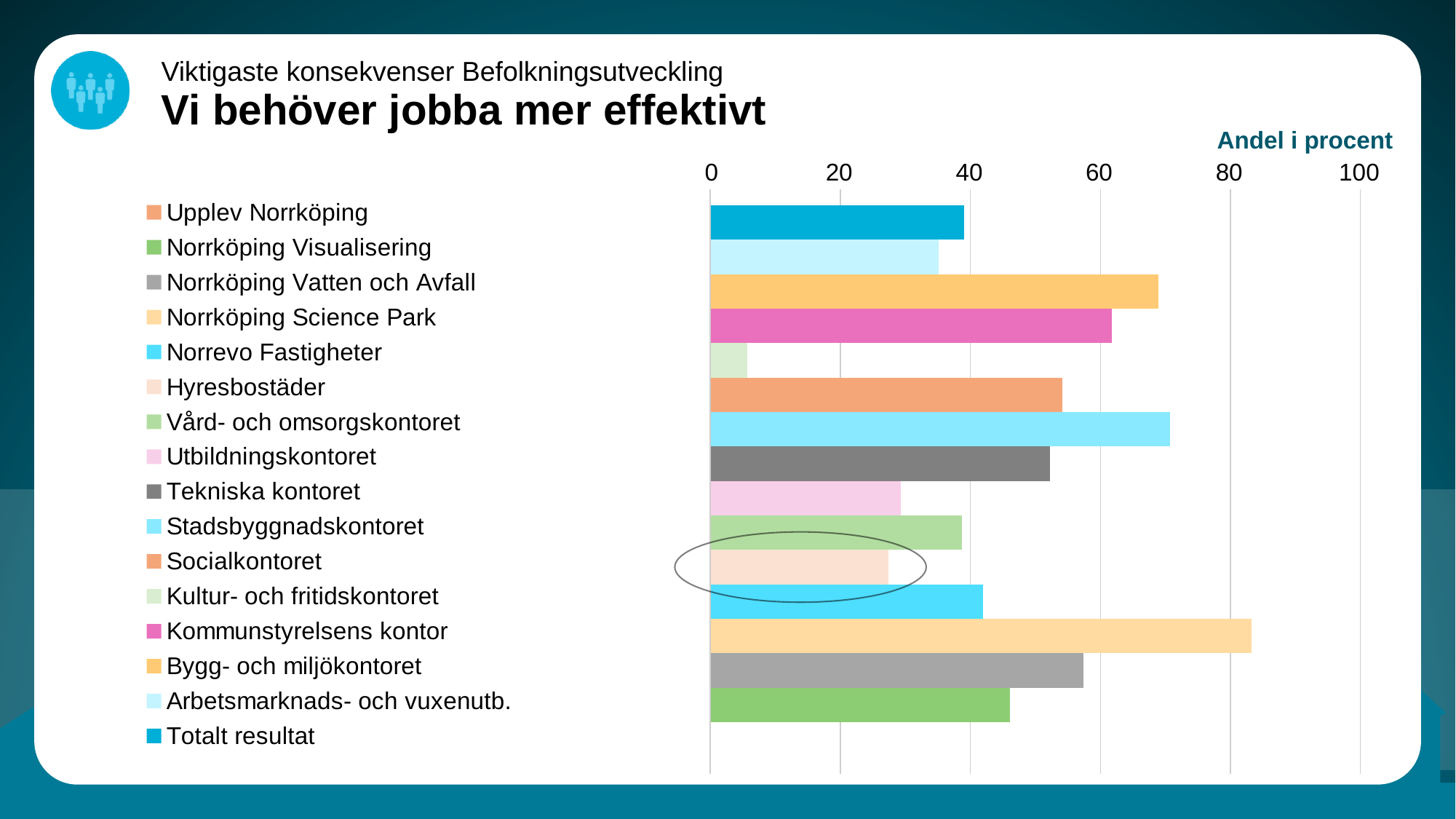
What kind of chart is shown on the slide? bar chart Is the value for Norrköping Science Park greater or less than 80? greater Is the value for Bygg- och miljökontoret greater or less than 60? greater Which is larger, the value for Norrköping Vatten och Avfall or the value for Norrköping Visualisering? Norrköping Vatten och Avfall Is the value for Kultur- och fritidskontoret greater or less than 20? less Which category has the highest value in the chart? Norrköping Science Park How many entries does the chart legend list? 16 What is the label shown above the chart's value axis? Andel i procent Which is larger, the value for Kommunstyrelsens kontor or the value for Socialkontoret? Kommunstyrelsens kontor What is the highest tick value shown on the chart's value axis? 100